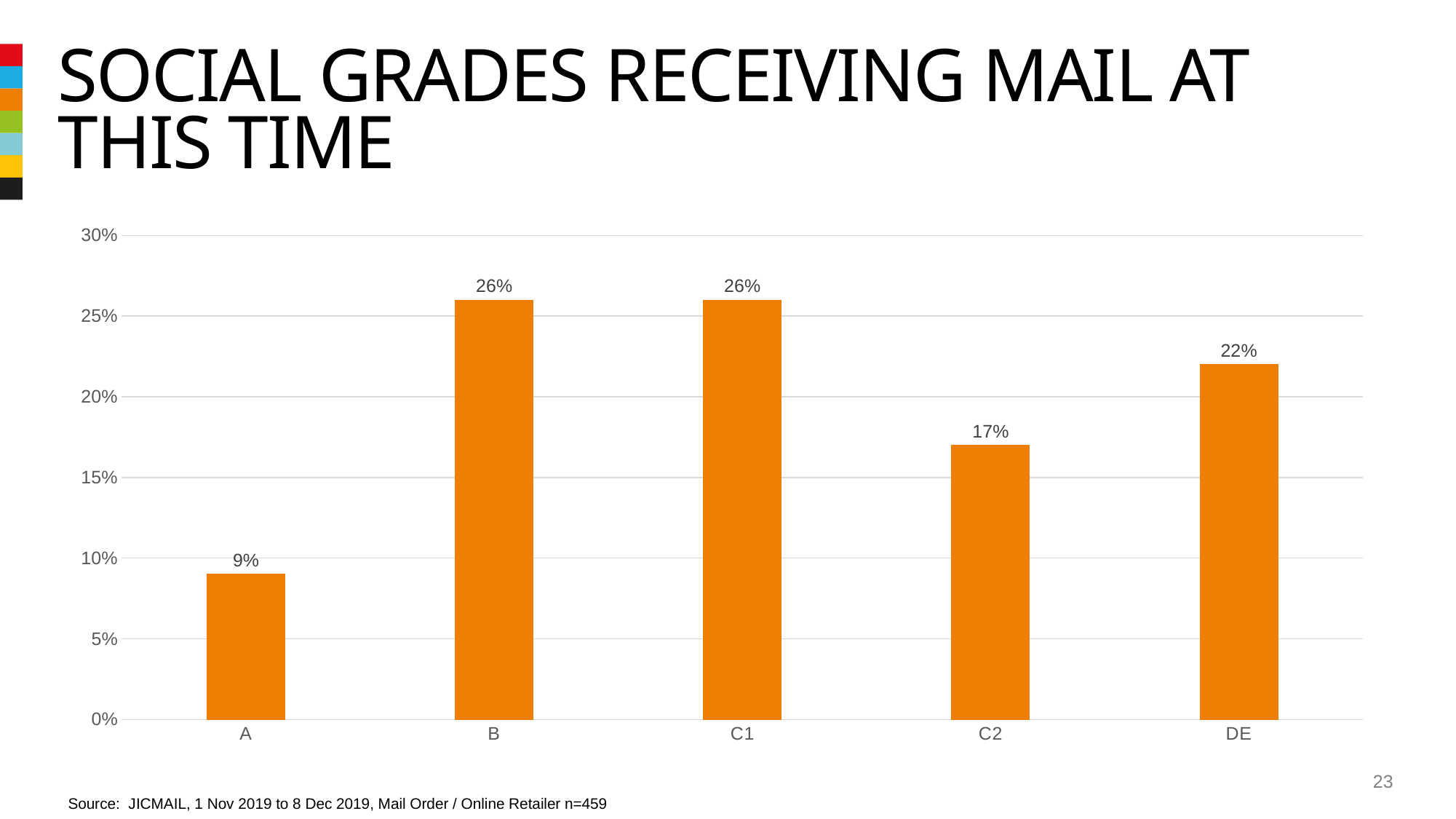
What kind of chart is shown on the slide? Bar chart Is the value for C1 greater or less than 20%? greater How many social grades are shown on the x axis? 5 What is the value for social grade DE? 22% What is the difference between the values for DE and C2? 5% What is the value for social grade B? 26% What is the title of the chart on the slide? Social grades receiving mail at this time Which is larger, the value for DE or the value for C2? DE Which social grade has the lowest value? A What is the value for social grade A? 9% What is the value for social grade C2? 17% What is the difference between the values for B and A? 17%